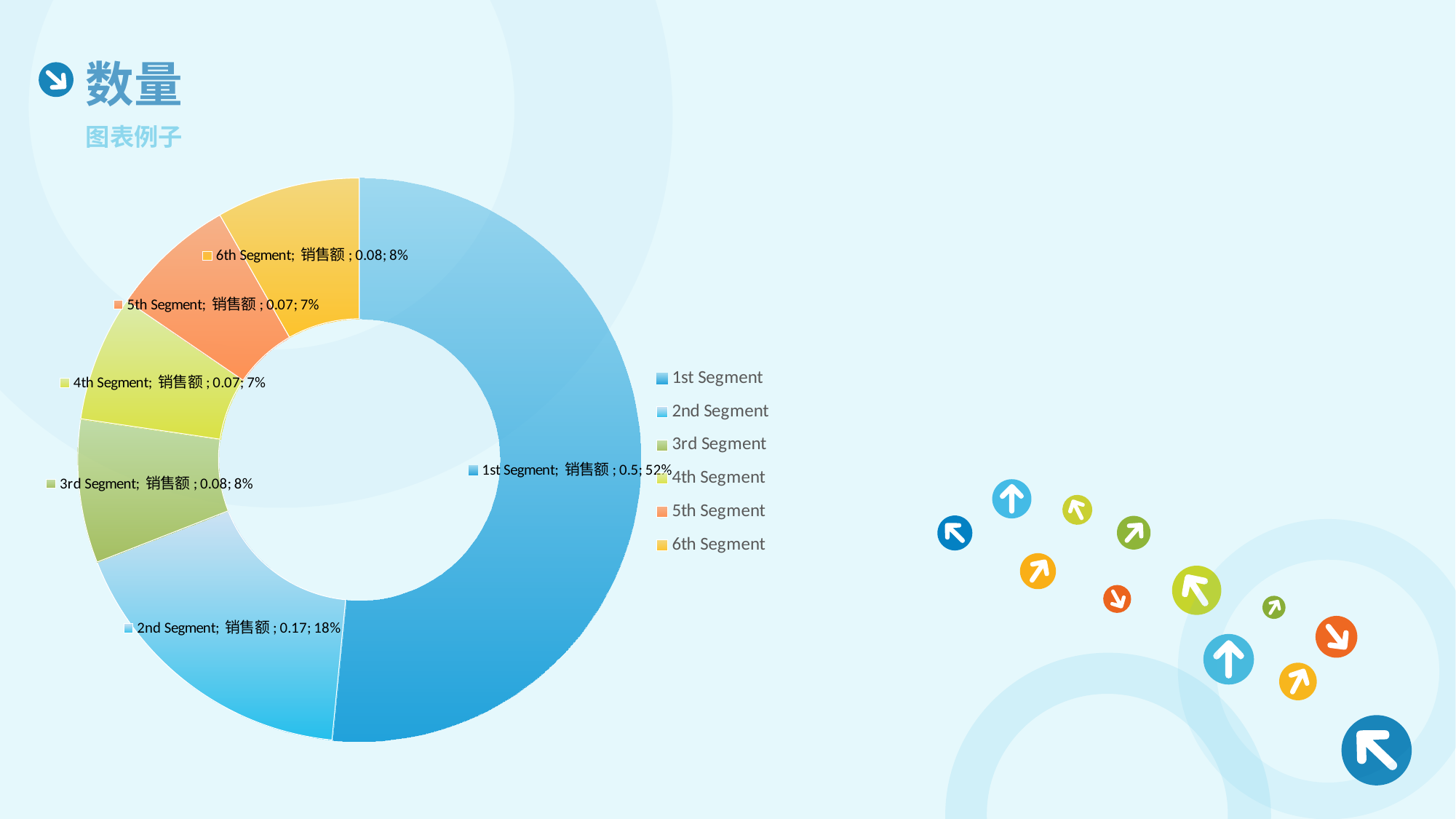
What is the difference between the 销售额 values of 1st Segment and 2nd Segment? 0.33 What percentage share does 2nd Segment have? 18% What type of chart is shown on the slide? Doughnut chart What percentage share does 1st Segment have? 52% Which segment has the largest share of the chart? 1st Segment What is the name of the data series shown in the data labels? 销售额 How many segments does the chart contain? 6 What is the 销售额 value for 1st Segment? 0.5 What is the 销售额 value for 5th Segment? 0.07 What is the 销售额 value for 2nd Segment? 0.17 What percentage share does 6th Segment have? 8% Which has a larger 销售额 value, 3rd Segment or 4th Segment? 3rd Segment